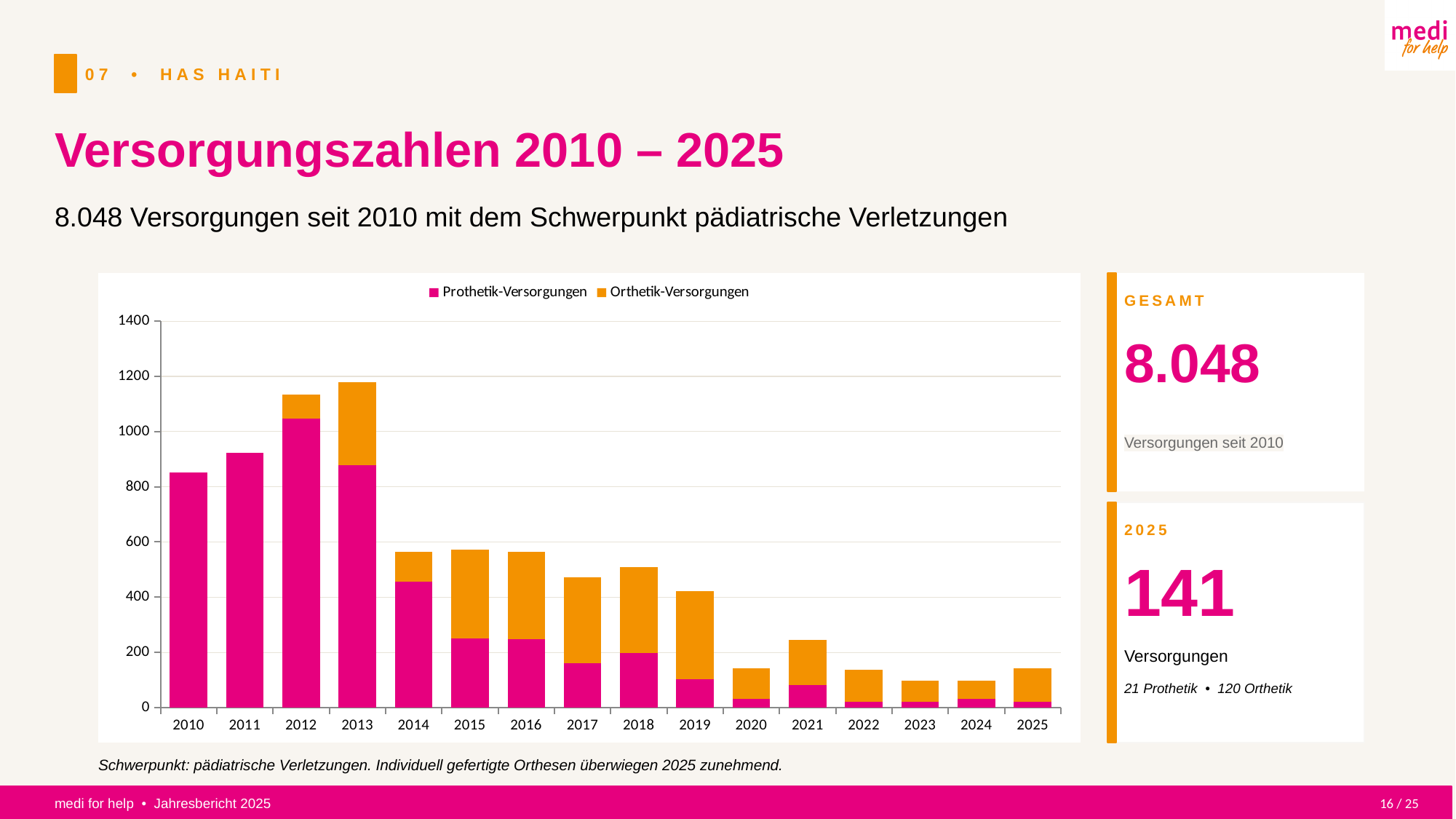
Is the total value for 2020 greater or less than 200? less How many years are shown on the x axis of the chart? 16 Do the total values rise or fall from 2013 to 2020? fall Which year has the highest Prothetik-Versorgungen value? 2012 What kind of chart is shown on the slide? stacked bar chart Which year has the highest total bar in the chart? 2013 Is the total value for 2014 greater or less than 600? less What are the two series named in the chart legend? Prothetik-Versorgungen and Orthetik-Versorgungen Which year has the larger total bar, 2019 or 2021? 2019 What is the Orthetik value for 2025 as stated on the slide? 120 How many series does the chart legend list? 2 Is the total value for 2010 greater or less than 800? greater